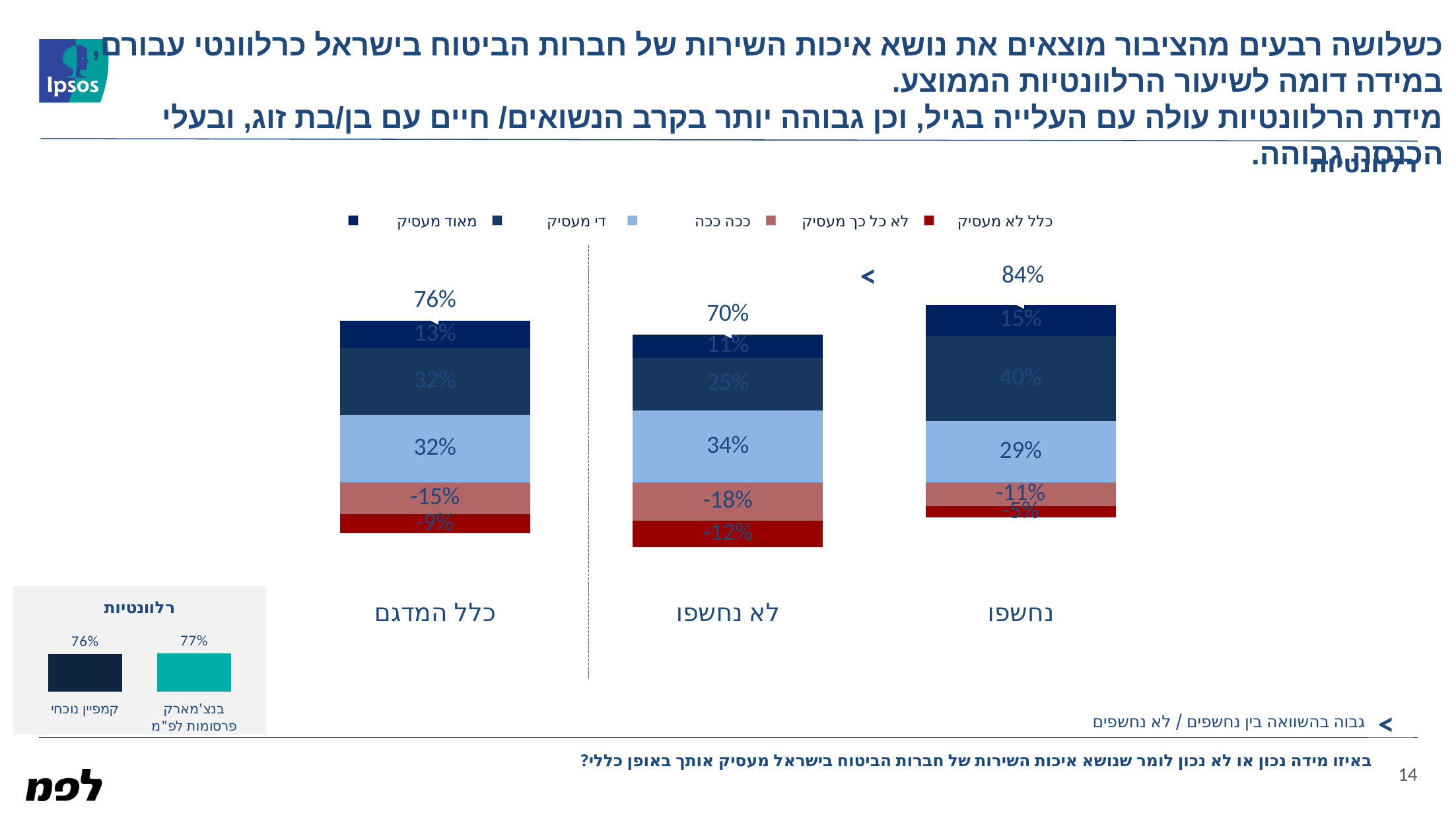
In the main stacked bar chart, what is the value of the 'ככה ככה' segment for 'לא נחשפו'? 34% In the main stacked bar chart, what is the difference between the total percentages shown for 'נחשפו' and 'לא נחשפו'? 14% How many categories are shown in the main stacked bar chart? 3 In the main stacked bar chart, what is the value of the 'כלל לא מעסיק' segment for 'נחשפו'? -5% In the main stacked bar chart, what is the value of the 'די מעסיק' segment for 'נחשפו'? 40% In the main stacked bar chart, what is the total percentage shown above the 'נחשפו' bar? 84% In the main stacked bar chart, which category has the highest total percentage shown above its bar? נחשפו In the main stacked bar chart, which category has the lowest total percentage shown above its bar? לא נחשפו In the small 'רלוונטיות' chart at the bottom left, what is the value for 'קמפיין נוכחי'? 76% In the main stacked bar chart, is the 'די מעסיק' segment larger for 'נחשפו' or for 'לא נחשפו'? נחשפו How many series does the legend of the main stacked bar chart list? 5 In the main stacked bar chart, what is the value of the 'מאוד מעסיק' segment for 'כלל המדגם'? 13%